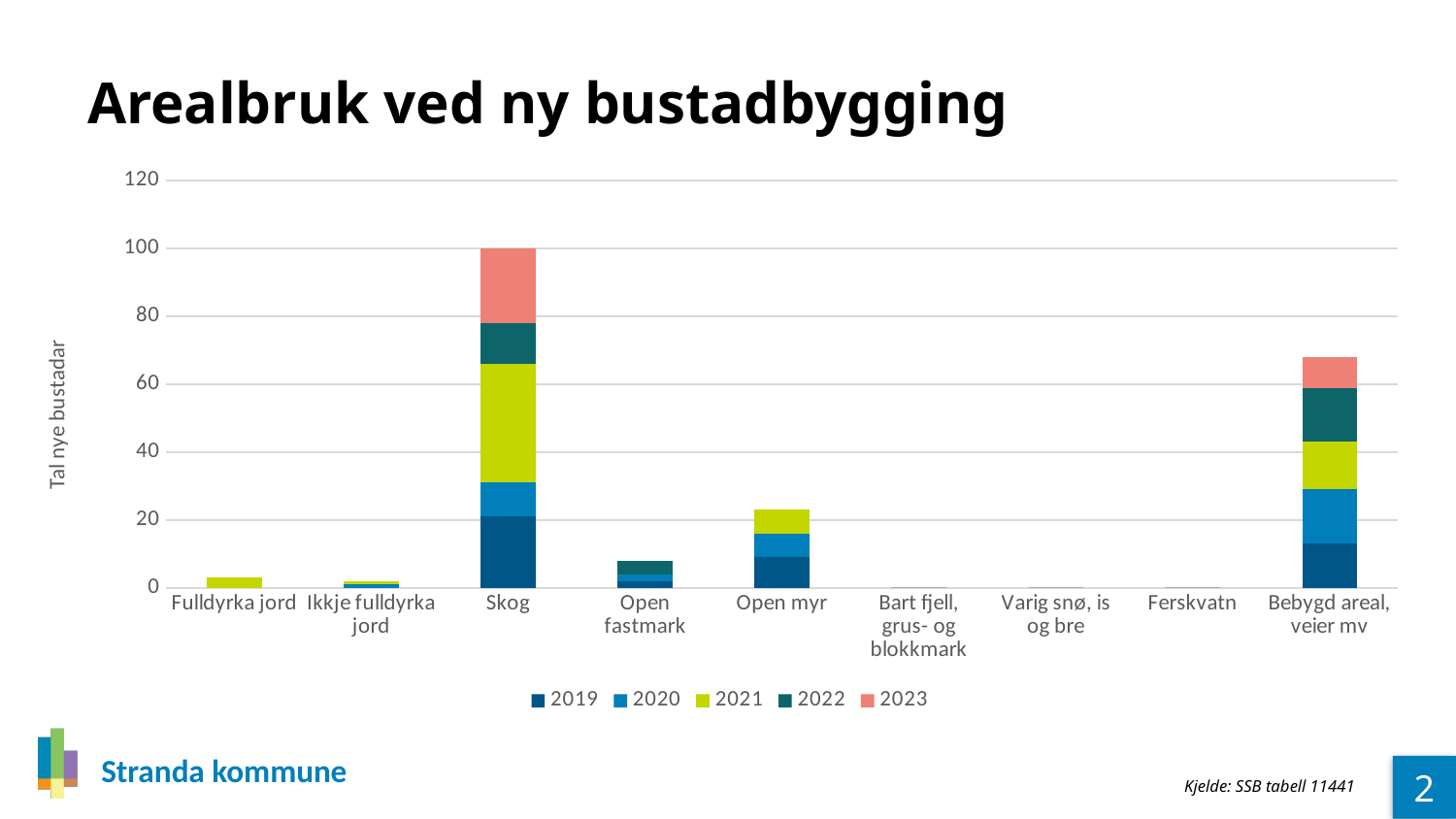
What is the label on the y axis? Tal nye bustadar Which category has the highest total stacked bar? Skog What is the title of the chart? Arealbruk ved ny bustadbygging Is the total value for Bebygd areal, veier mv greater or less than 60? greater Which has a larger total stacked bar, Skog or Bebygd areal, veier mv? Skog Is the total value for Open fastmark greater or less than 20? less Is the total value for Fulldyrka jord greater or less than 20? less How many categories are shown on the x axis? 9 What is the total of the stacked bar for Skog? 100 What kind of chart is shown on the slide? Stacked bar chart How many series does the legend list? 5